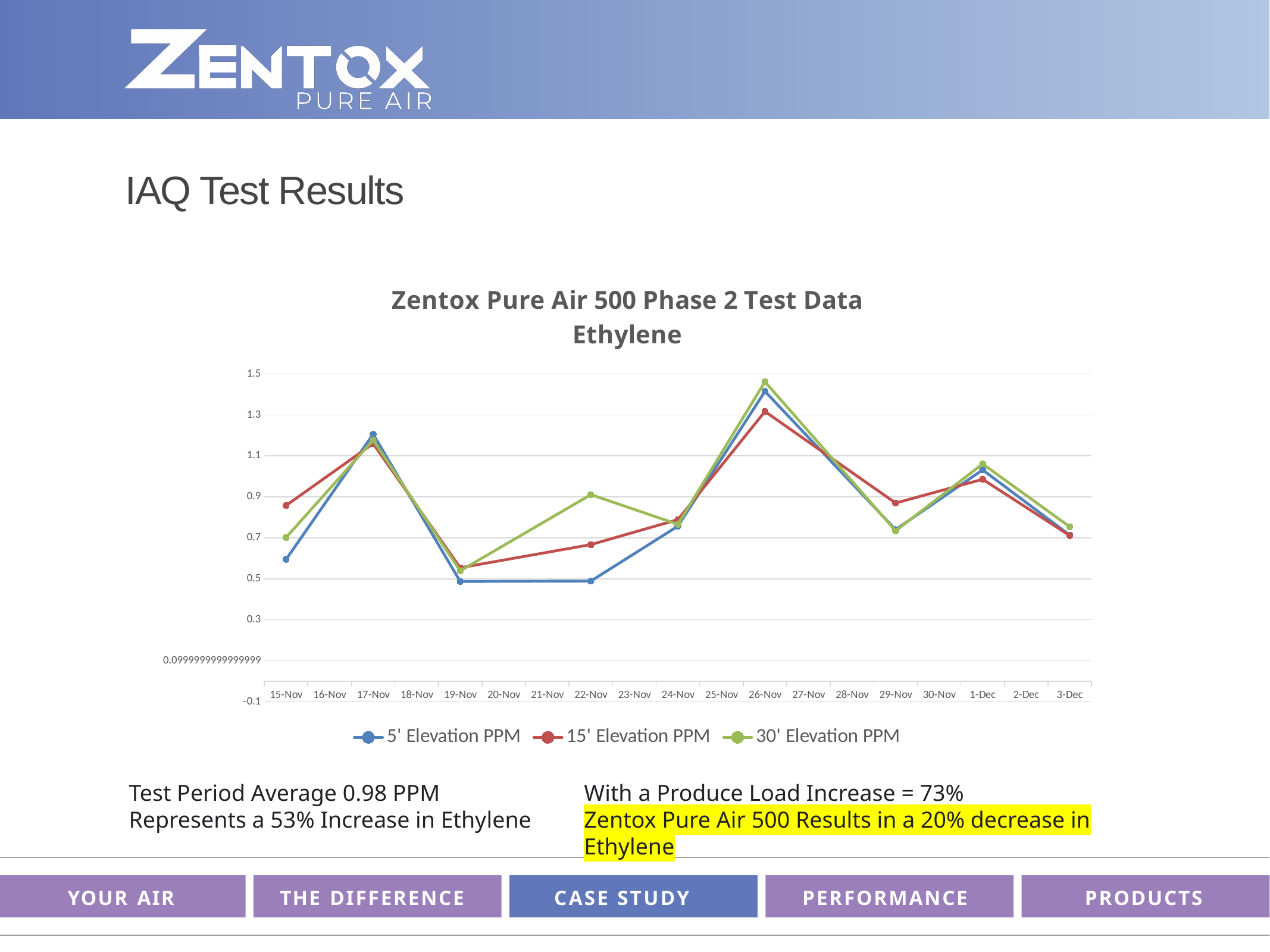
How many series does the legend list? 3 On which date does the 15' Elevation PPM series reach its highest value? 26-Nov Do the values for all three series rise or fall between 26-Nov and 29-Nov? fall How many date labels are shown along the x axis? 19 Is the value for 30' Elevation PPM on 26-Nov greater or less than 1.3? greater What is the title of the chart? Zentox Pure Air 500 Phase 2 Test Data Ethylene On 15-Nov, which is larger: 15' Elevation PPM or 5' Elevation PPM? 15' Elevation PPM Is the value for 5' Elevation PPM on 15-Nov greater or less than 0.7? less On 22-Nov, which is larger: 30' Elevation PPM or 5' Elevation PPM? 30' Elevation PPM On which date does the 30' Elevation PPM series reach its highest value? 26-Nov Is the value for 15' Elevation PPM on 15-Nov greater or less than 0.7? greater What kind of chart is shown on the slide? Line chart